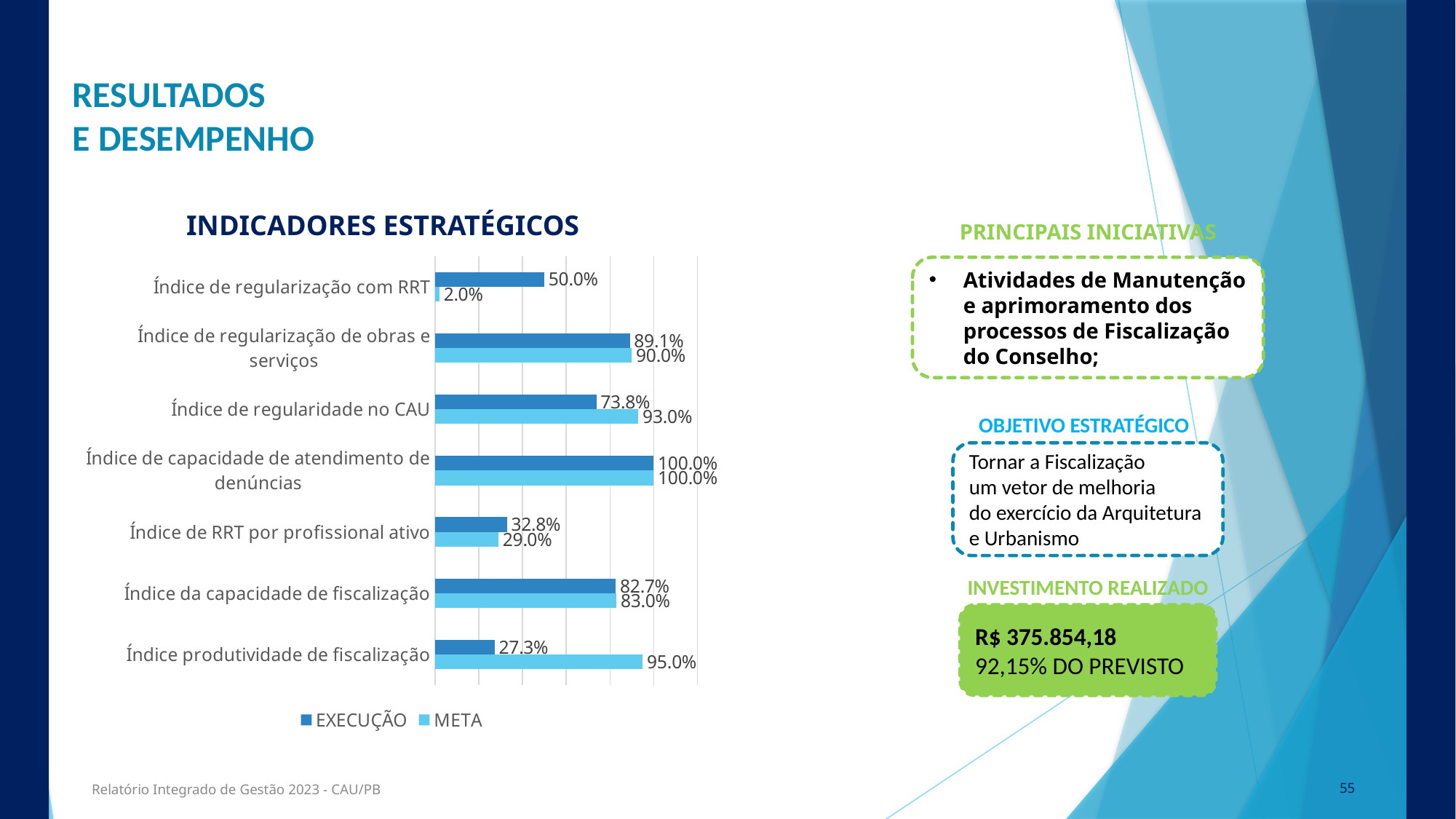
How many series does the legend list? 2 Which category has the highest EXECUÇÃO value? Índice de capacidade de atendimento de denúncias For Índice de RRT por profissional ativo, which is larger, EXECUÇÃO or META? EXECUÇÃO What is the EXECUÇÃO value for Índice de regularidade no CAU? 73.8% What is the META value for Índice de RRT por profissional ativo? 29.0% Which category has the lowest META value? Índice de regularização com RRT What is the difference between the META and EXECUÇÃO values for Índice produtividade de fiscalização? 67.7% Which category has the lowest EXECUÇÃO value? Índice produtividade de fiscalização What is the EXECUÇÃO value for Índice de regularização com RRT? 50.0% What type of chart is shown on the slide? Bar chart What is the META value for Índice produtividade de fiscalização? 95.0% How many categories are shown in the chart? 7